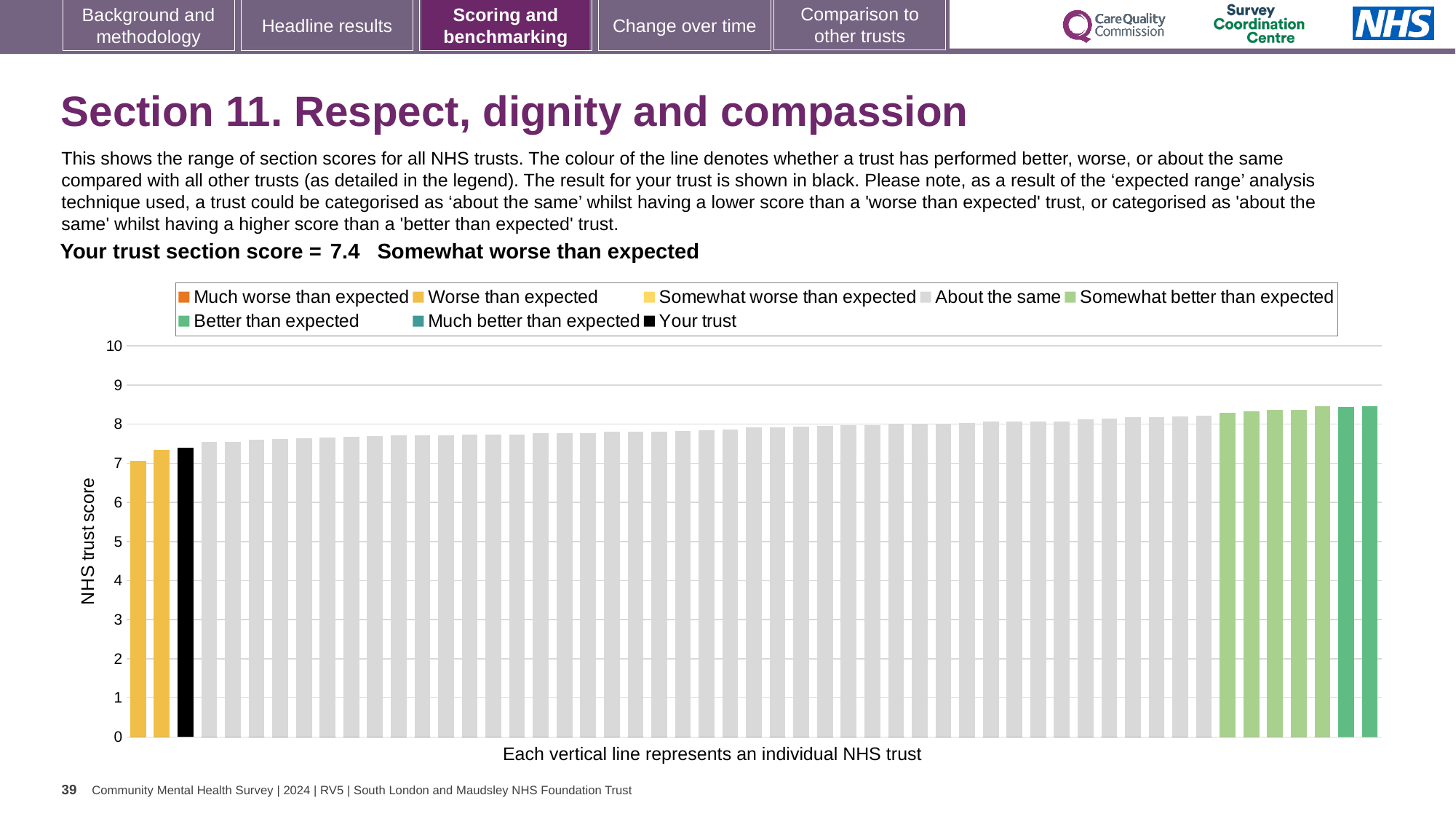
Is the value of the black 'Your trust' bar greater or less than 5? greater What is the section score for your trust shown on the slide? 7.4 Do the bar values rise or fall from left to right across the chart? rise What colour is the bar representing your trust? black What kind of chart is shown on the slide? bar chart What is the label on the vertical axis of the chart? NHS trust score How many entries does the chart legend list? 8 Which category does your trust fall into for this section? Somewhat worse than expected Is the value of the leftmost bar in the chart greater or less than 8? less How many bars in the chart are coloured black? 1 Is the value of the tallest bar in the chart greater or less than 8? greater